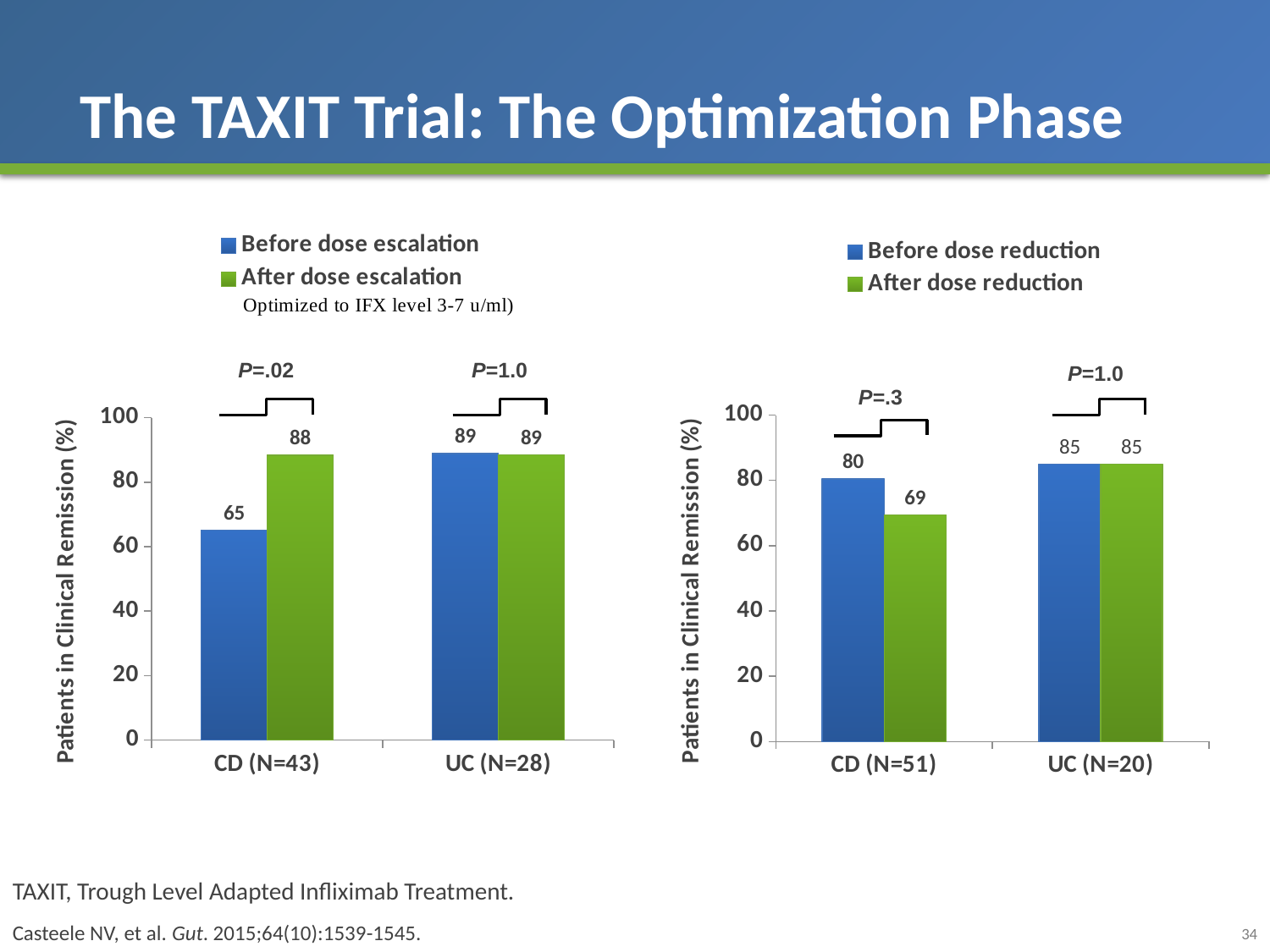
In the left chart (dose escalation), which bar has the lowest value? CD (N=43) before dose escalation In the left chart (dose escalation), what is the value for UC (N=28) before dose escalation? 89 What kind of chart is the left chart (dose escalation)? Bar chart In the right chart (dose reduction), what is the value for CD (N=51) after dose reduction? 69 In the left chart (dose escalation), what is the value for CD (N=43) before dose escalation? 65 In the right chart (dose reduction), which is larger for CD (N=51): the value before dose reduction or after dose reduction? Before dose reduction In the right chart (dose reduction), what is the difference between the before and after dose reduction values for CD (N=51)? 11 In the right chart (dose reduction), what is the value for UC (N=20) before dose reduction? 85 How many series does the legend of the right chart (dose reduction) list? 2 In the left chart (dose escalation), what is the value for CD (N=43) after dose escalation? 88 How many categories are shown on the x axis of the left chart (dose escalation)? 2 In the left chart (dose escalation), what is the difference between the after and before dose escalation values for CD (N=43)? 23